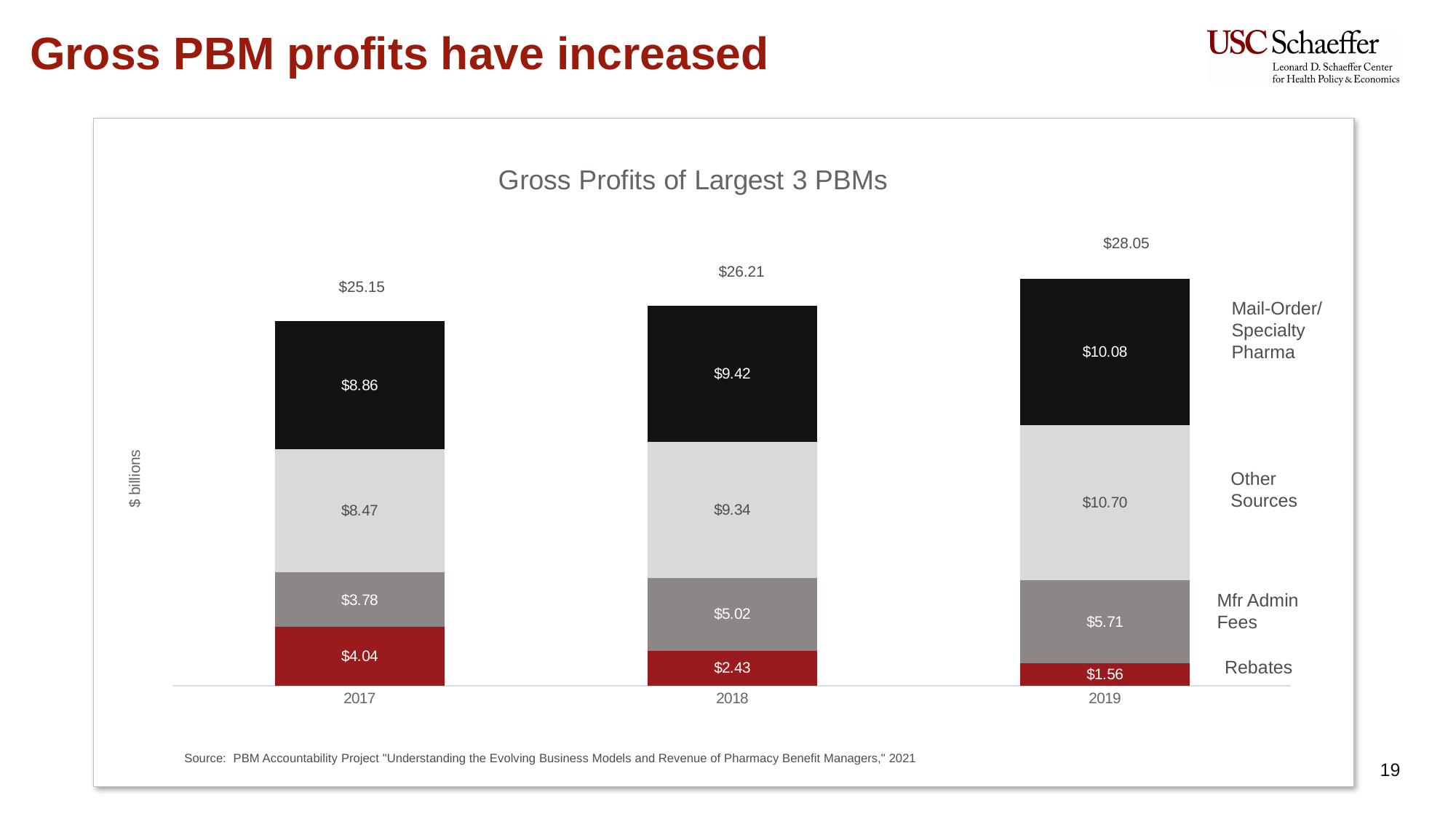
What is the value for Mfr Admin Fees in 2018? $5.02 What is the difference between the Mail-Order/Specialty Pharma value in 2019 and in 2017? $1.22 What is the value for Mail-Order/Specialty Pharma in 2019? $10.08 What is the value for Other Sources in 2018? $9.34 Which year has the highest total gross profit? 2019 How many years are shown on the x axis? 3 What is the value for Rebates in 2017? $4.04 What is the difference between the total for 2019 and the total for 2017? $2.90 In which year is the Rebates value lowest? 2019 What is the total gross profit shown for the 2019 bar? $28.05 In 2018, which is larger: Mail-Order/Specialty Pharma or Other Sources? Mail-Order/Specialty Pharma How many series are stacked in each bar? 4